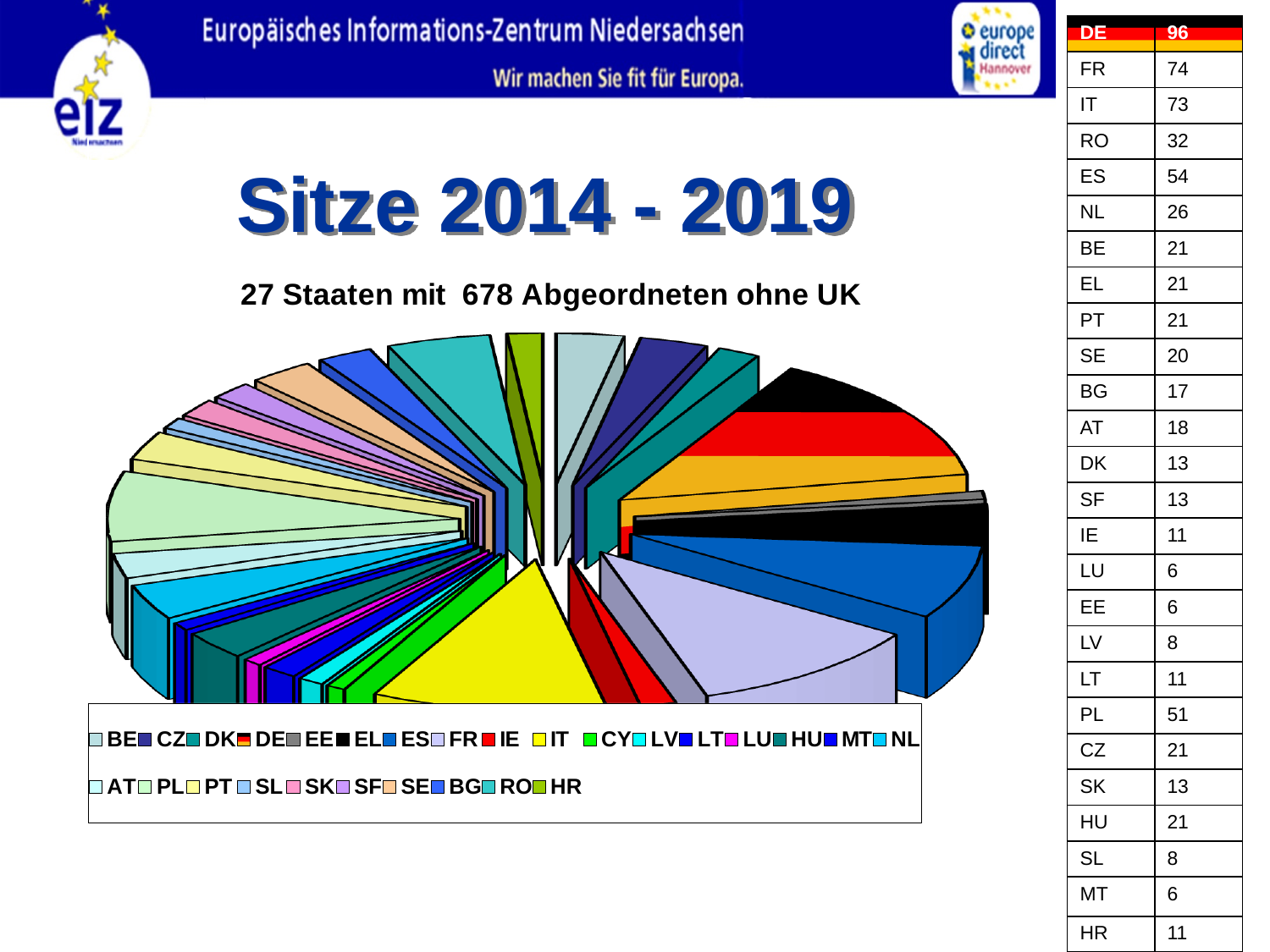
According to the table on the slide, how many seats does DE have? 96 According to the table on the slide, how many seats does RO have? 32 What is the difference in seats between DE (96) and FR (74)? 22 How many countries (categories) does the chart's legend list? 27 What total number of seats (Abgeordnete) does the subtitle state for the 27 states? 678 According to the table on the slide, how many seats does FR have? 74 What is the title of the chart on the slide? 27 Staaten mit 678 Abgeordneten ohne UK Which country has the largest slice in the pie chart? DE According to the table on the slide, how many seats does ES have? 54 Which has more seats, DE or FR? DE What kind of chart is shown on the slide? pie chart According to the table on the slide, how many seats does PL have? 51